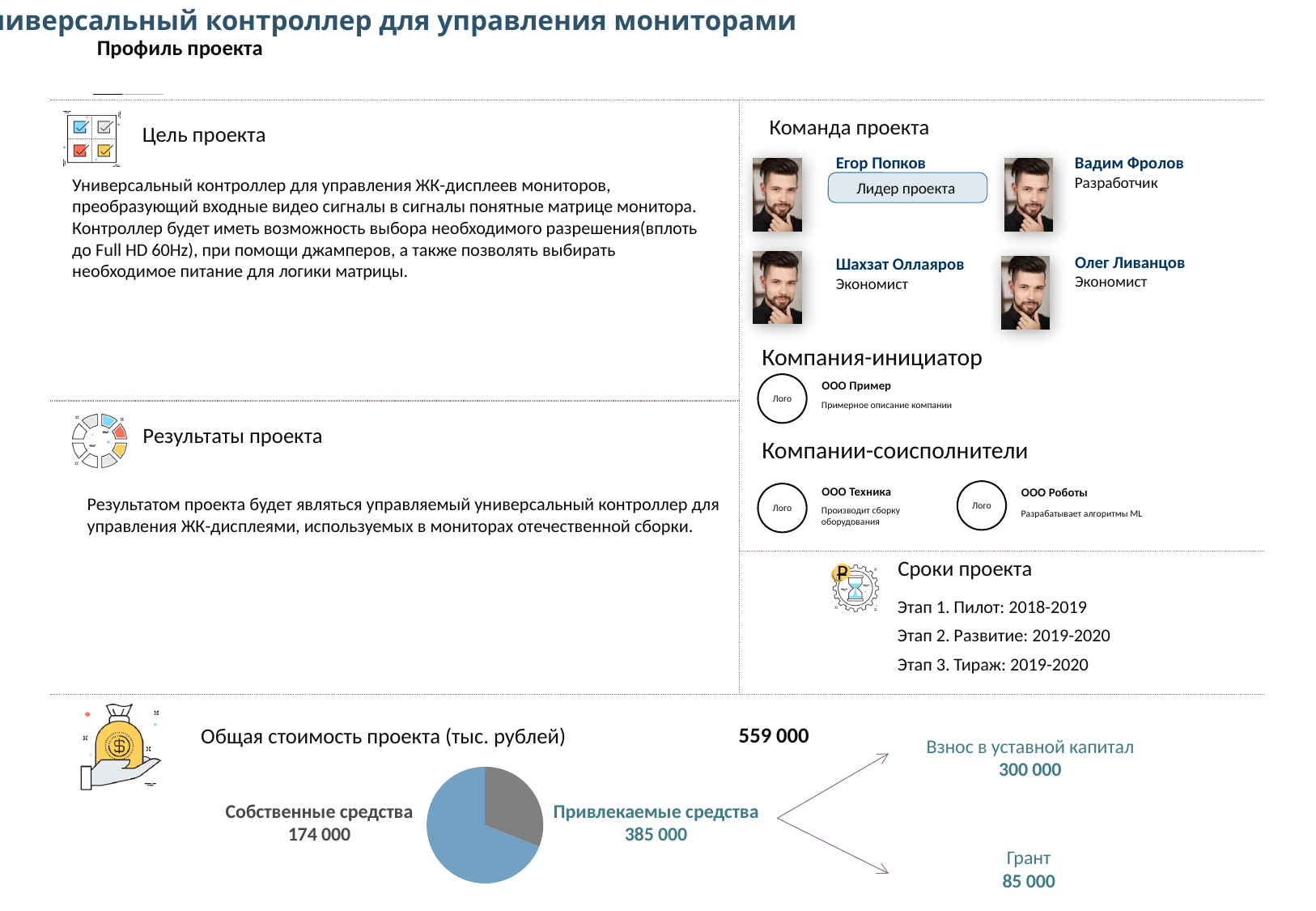
Which slice of the pie chart is larger: Собственные средства or Привлекаемые средства? Привлекаемые средства What is the total project cost (Общая стоимость проекта) shown next to the pie chart, in thousands of rubles? 559 000 What kind of chart is shown at the bottom of the slide? Pie chart Which colour represents Привлекаемые средства in the pie chart? Blue What is the value of Грант shown in the breakdown of Привлекаемые средства? 85 000 What is the value for Собственные средства in the pie chart? 174 000 What is the value of Взнос в уставной капитал shown in the breakdown of Привлекаемые средства? 300 000 Which colour represents Собственные средства in the pie chart? Grey Which category in the pie chart has the smallest value? Собственные средства What is the difference between Привлекаемые средства and Собственные средства in the pie chart? 211 000 How many slices does the pie chart have? 2 What is the value for Привлекаемые средства in the pie chart? 385 000